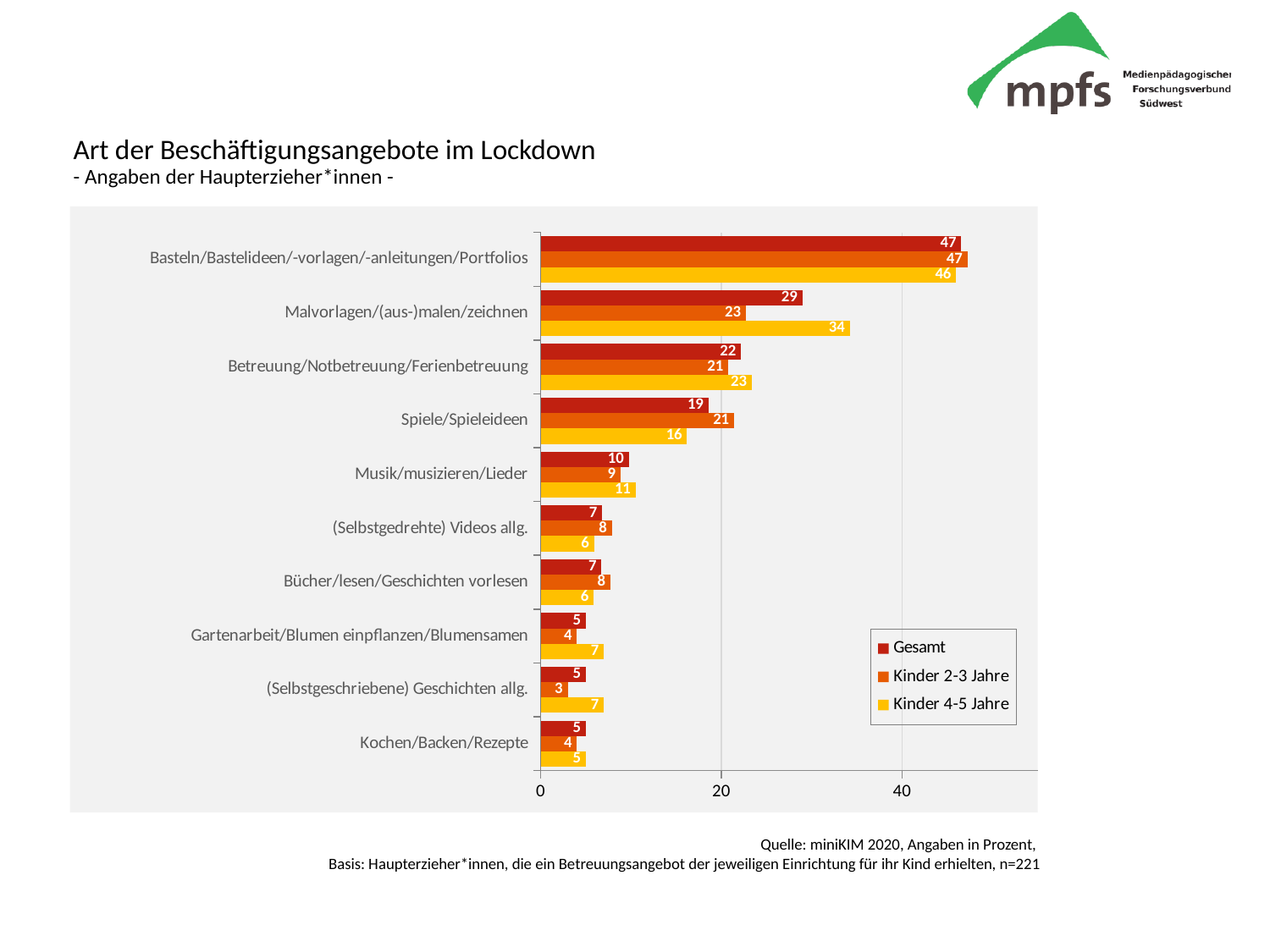
Which category has the lowest Kinder 2-3 Jahre value? (Selbstgeschriebene) Geschichten allg. For Spiele/Spieleideen, which is larger: the Kinder 2-3 Jahre value or the Kinder 4-5 Jahre value? Kinder 2-3 Jahre How many series does the legend list? 3 What is the value for Gesamt for Malvorlagen/(aus-)malen/zeichnen? 29 How many categories are shown on the chart? 10 Is the Gesamt value for Betreuung/Notbetreuung/Ferienbetreuung greater or less than 20? greater What is the value for Kinder 2-3 Jahre for (Selbstgeschriebene) Geschichten allg.? 3 Which category has the highest Gesamt value? Basteln/Bastelideen/-vorlagen/-anleitungen/Portfolios What is the value for Kinder 4-5 Jahre for Spiele/Spieleideen? 16 What is the difference between the Kinder 4-5 Jahre and Kinder 2-3 Jahre values for Malvorlagen/(aus-)malen/zeichnen? 11 What kind of chart is shown on the slide? Bar chart What is the title of the chart? Art der Beschäftigungsangebote im Lockdown